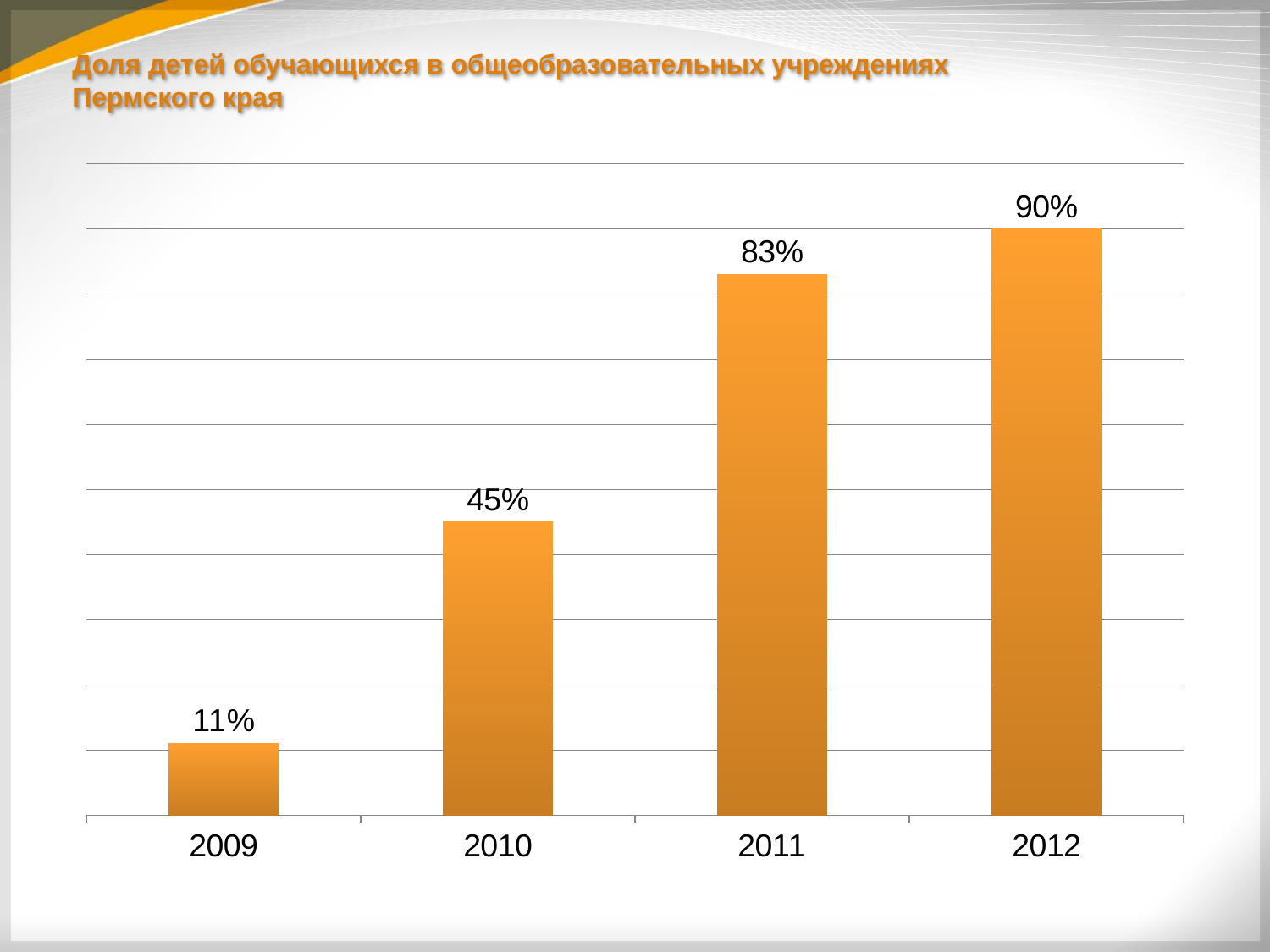
Which year has the highest value? 2012 What is the difference between the values for 2010 and 2009? 34% What is the difference between the values for 2012 and 2011? 7% Do the values rise or fall from 2009 to 2012? rise Which is larger, the value for 2010 or the value for 2011? 2011 What is the value for 2009? 11% What is the value for 2010? 45% Which year has the lowest value? 2009 What is the value for 2011? 83% What is the value for 2012? 90% How many years are shown on the x axis? 4 What kind of chart is this? bar chart